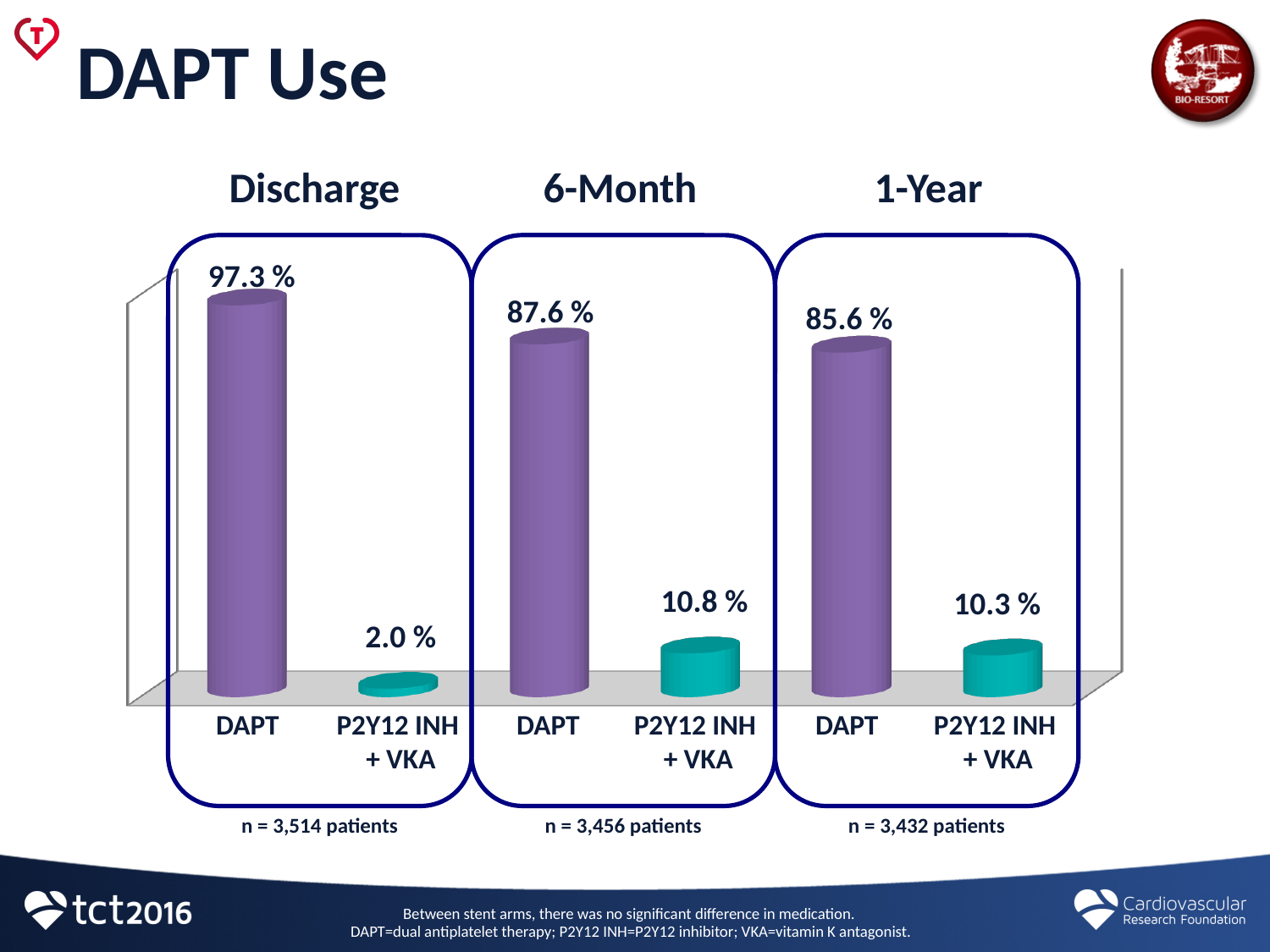
What is the DAPT use at Discharge? 97.3 % What is the value for P2Y12 INH + VKA at 6-Month? 10.8 % Which time point has the highest DAPT use? Discharge What is the DAPT use at 1-Year? 85.6 % What is the value for P2Y12 INH + VKA at Discharge? 2.0 % How many bars are plotted on the chart? 6 How many patients are included at the 6-Month time point? n = 3,456 patients Which bar on the chart has the lowest value? P2Y12 INH + VKA at Discharge Is the P2Y12 INH + VKA value larger at 6-Month or at 1-Year? 6-Month What is the difference between DAPT use at Discharge and at 1-Year? 11.7 % What kind of chart is shown on the slide? Bar chart How does DAPT use change from Discharge to 6-Month to 1-Year? It falls